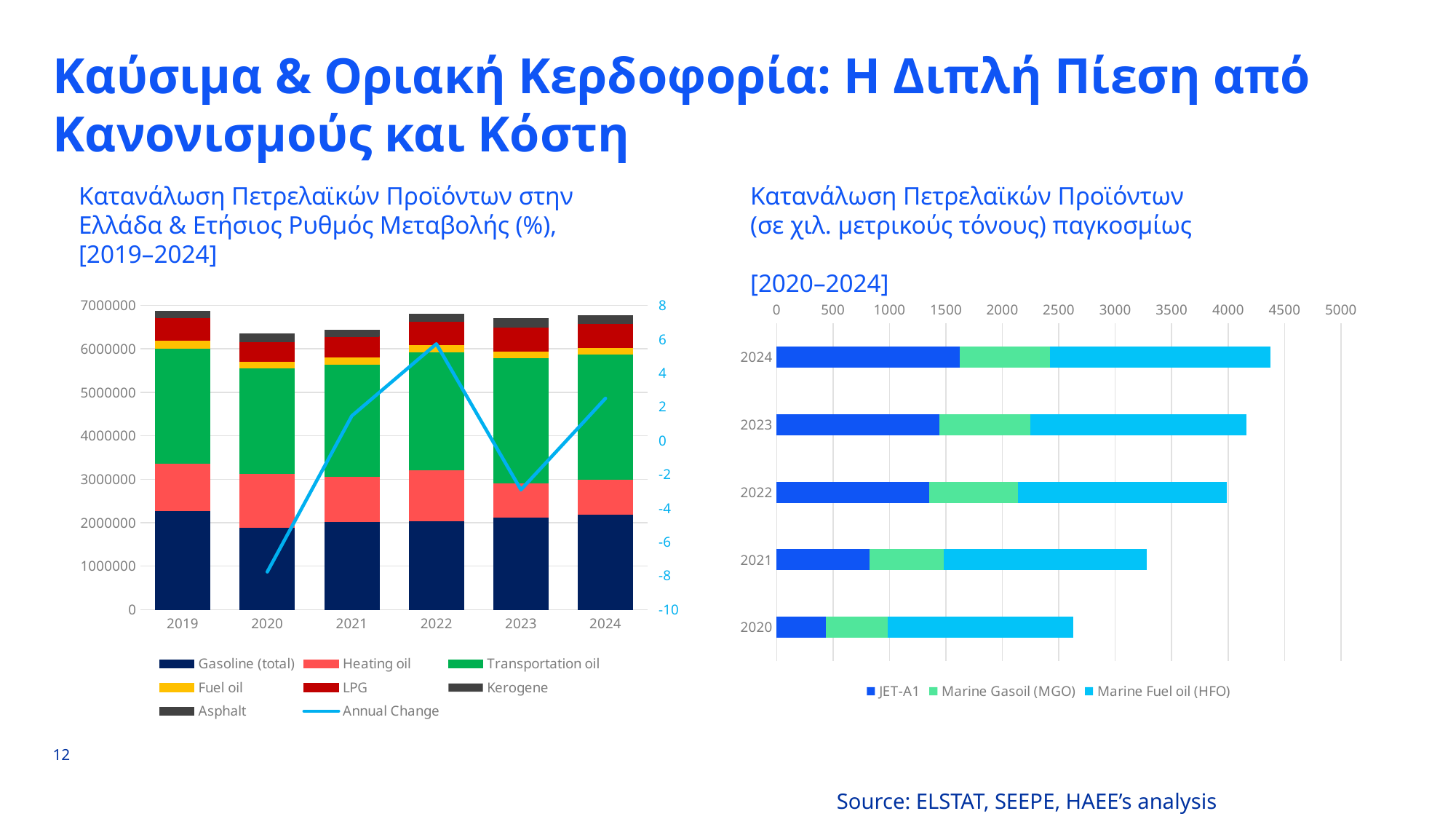
In the left chart, is the Annual Change value for 2023 greater or less than 0? less In the right chart, is the JET-A1 value for 2020 greater or less than 500? less In the left chart, in which year is the Annual Change line at its highest? 2022 How many series does the legend of the right chart list? 3 In the left chart, is the Gasoline (total) value for 2019 greater or less than 2000000? greater In the left chart, in which year is the Annual Change line at its lowest? 2020 What type of chart is the right chart (global oil product consumption)? Horizontal stacked bar chart How many entries does the legend of the left chart list? 8 How many years are shown on the x axis of the left chart? 6 In the right chart, which year has the largest total bar? 2024 In the right chart, do the total bars rise or fall from 2020 to 2024? rise What type of chart is the left chart (Greek oil product consumption)? Stacked bar chart with a line